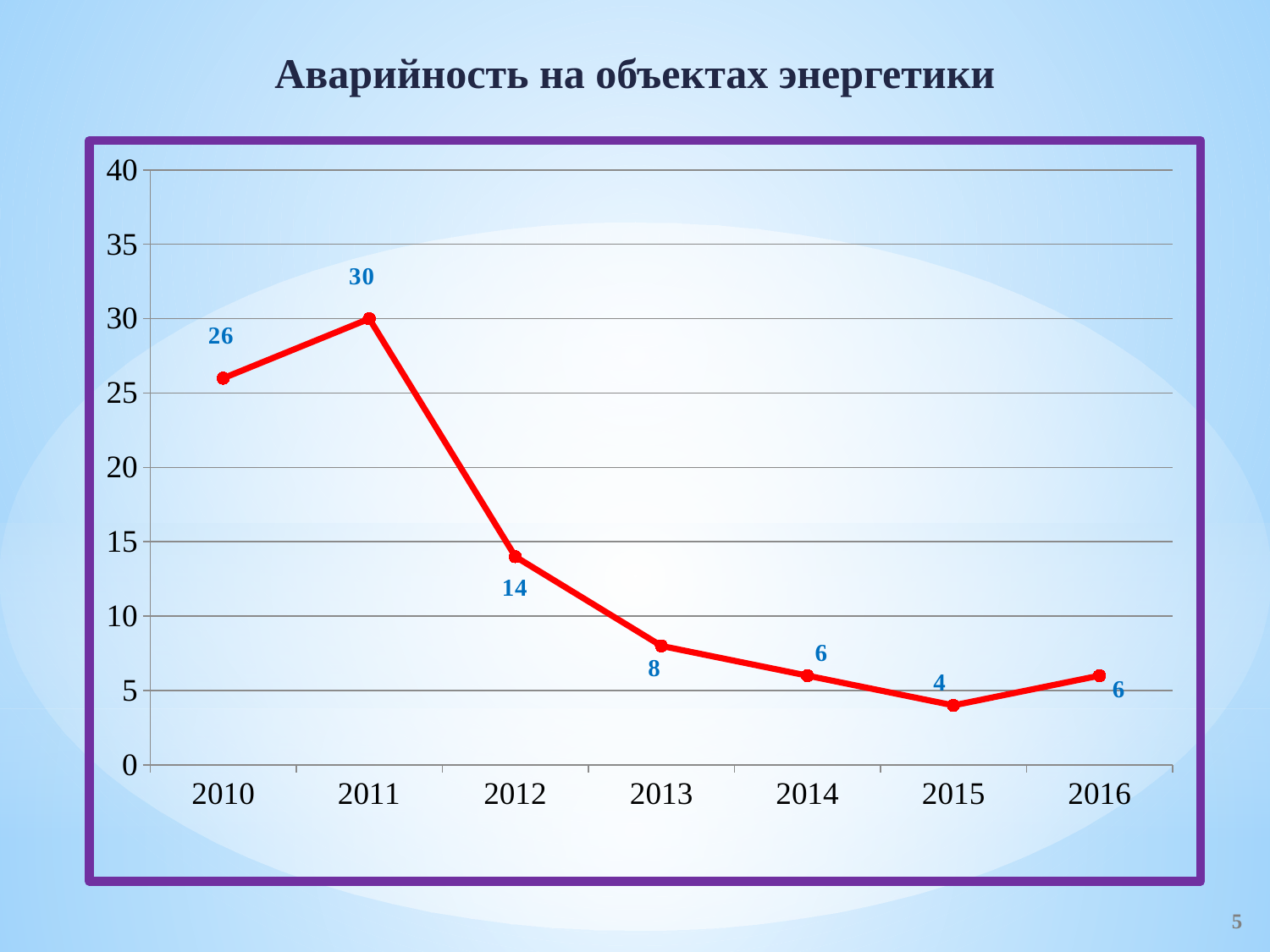
What is the value for 2015? 4 Is the value for 2010 greater or less than 25? greater What kind of chart is shown on the slide? line chart What is the difference between the values for 2010 and 2016? 20 How many years are plotted on the chart? 7 Which year has the lowest value? 2015 What is the difference between the values for 2011 and 2012? 16 Which year has the highest value? 2011 Which is larger, the value for 2012 or the value for 2014? 2012 What is the value for 2011? 30 What is the value for 2013? 8 What is the title of the chart on the slide? Аварийность на объектах энергетики